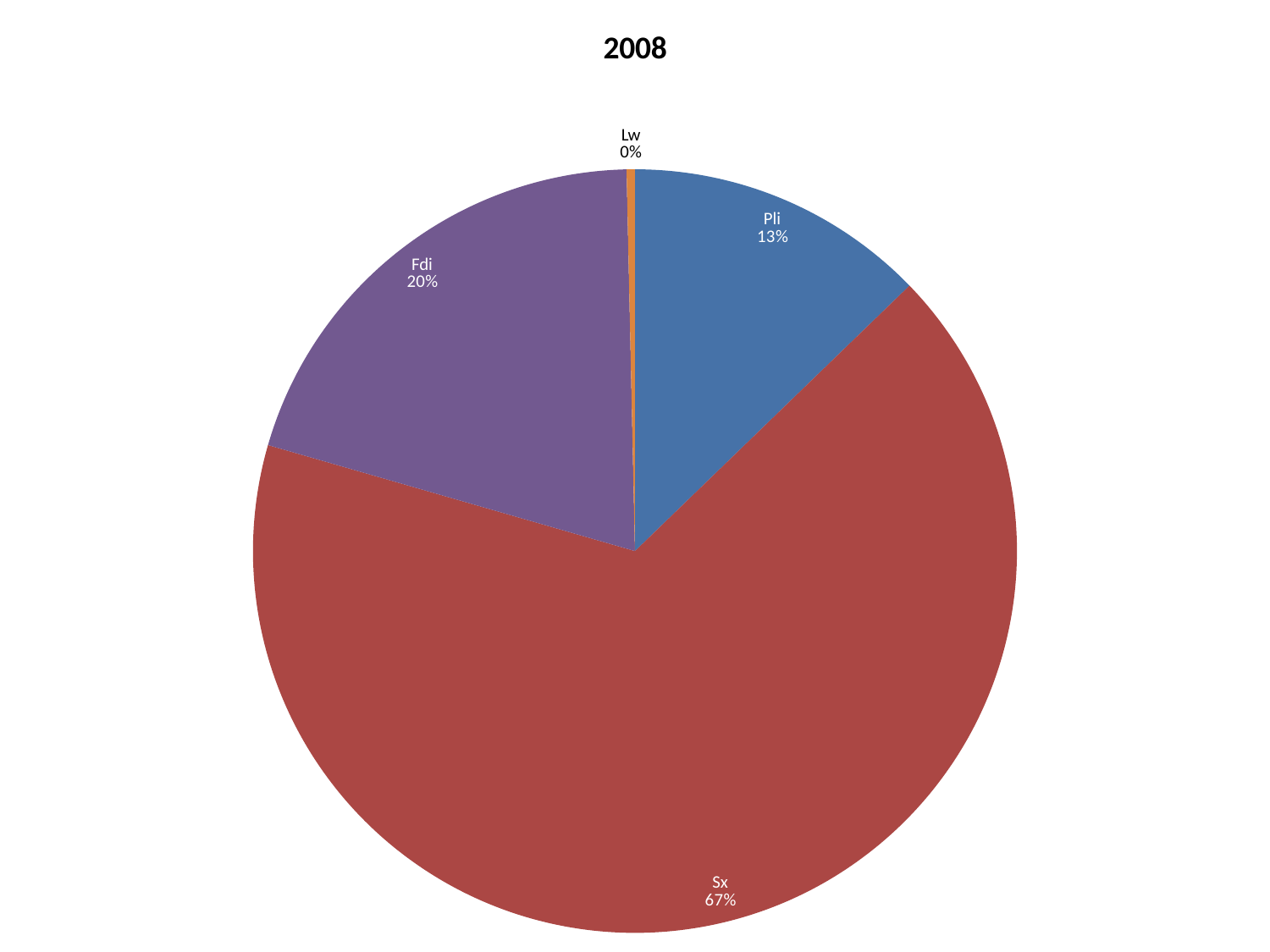
What colour is the Sx slice? red What share of the pie does Sx have? 67% Which category has the largest slice of the pie? Sx Which category has the smallest slice of the pie? Lw Which is larger, the share for Fdi or the share for Pli? Fdi What is the difference in percentage points between the Sx share and the Fdi share? 47 What is the title of the chart? 2008 How many slices does the pie chart have? 4 What share of the pie does Pli have? 13% What share of the pie does Lw have? 0% What kind of chart is shown on the slide? pie chart